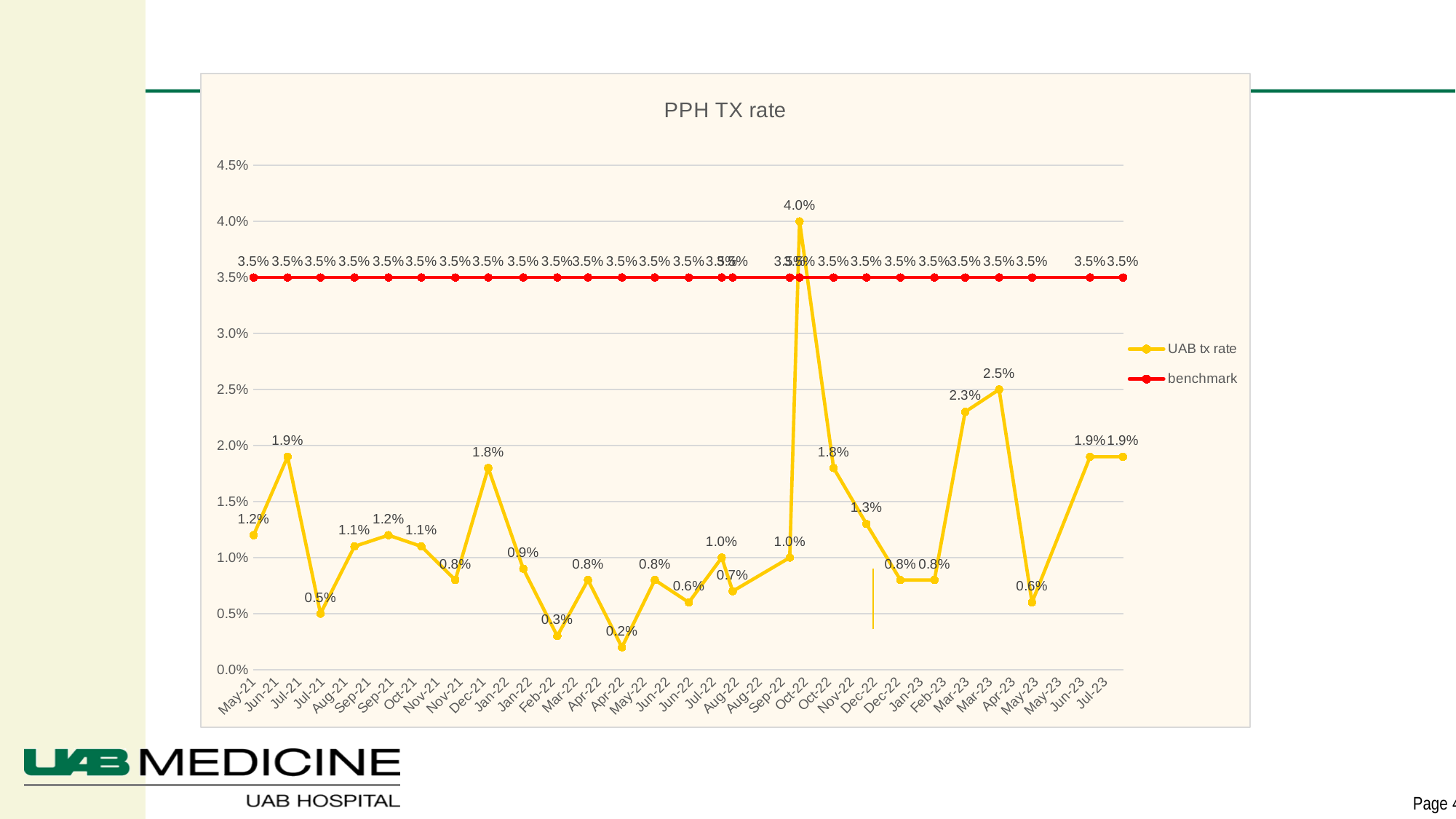
What value does the benchmark series hold across the chart? 3.5% Is the lowest UAB tx rate value greater or less than 0.5%? less What are the two series named in the legend? UAB tx rate and benchmark How many series does the legend list? 2 What is the UAB tx rate value at the last point on the chart (Jul-23)? 1.9% Which is larger, the peak UAB tx rate or the benchmark? the peak UAB tx rate What kind of chart is shown on the slide? line chart What is the title of the chart? PPH TX rate By how much does the peak UAB tx rate of 4.0% exceed the 3.5% benchmark? 0.5% What is the highest value reached by the UAB tx rate series? 4.0% What is the difference between the 2.5% and 2.3% UAB tx rate values in early 2023? 0.2% What is the lowest value of the UAB tx rate series? 0.2%